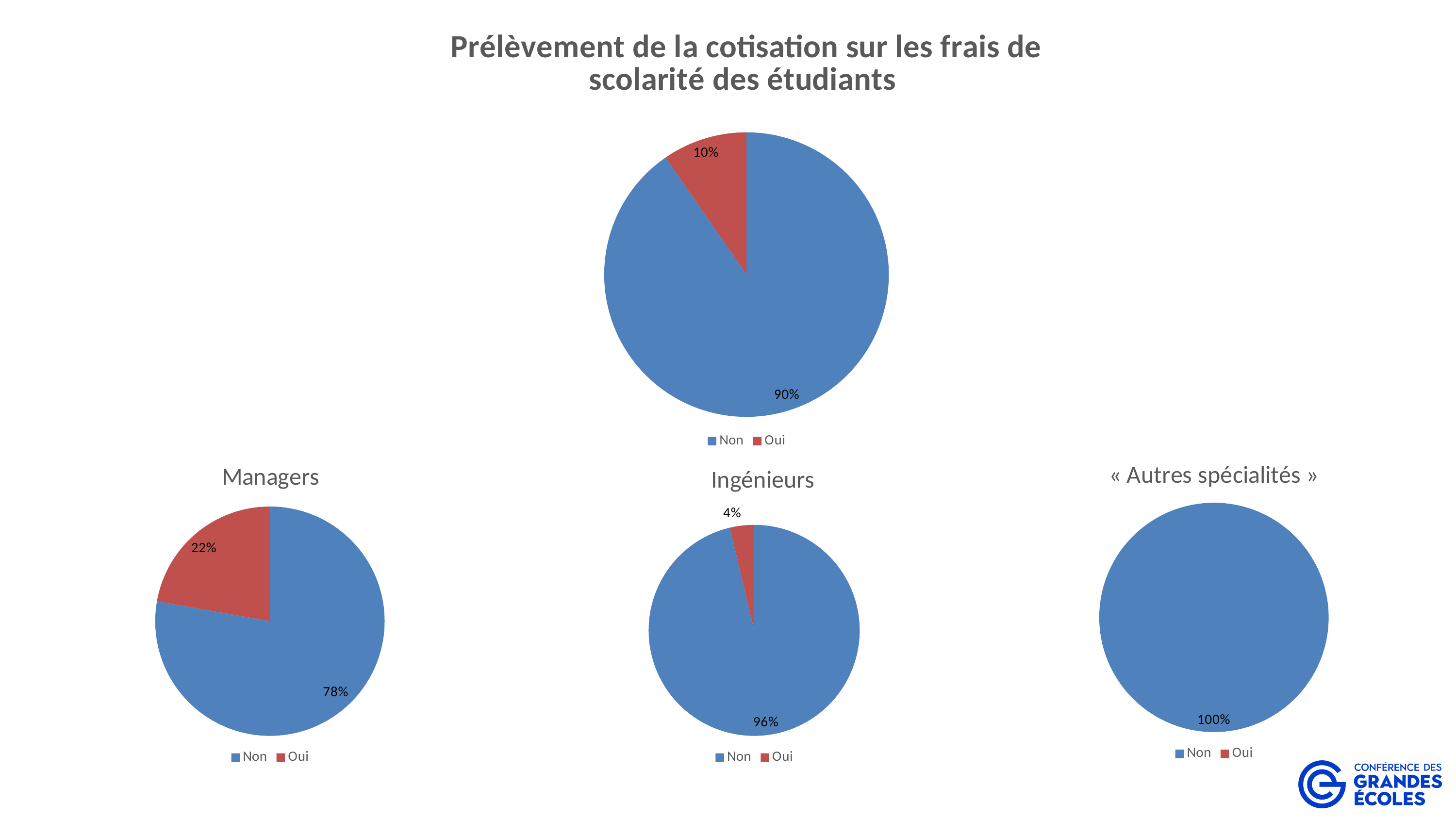
In the '« Autres spécialités »' chart, what share is labelled for 'Non'? 100% How many entries does the legend of the 'Managers' chart list? 2 What kind of chart is the 'Ingénieurs' chart? Pie chart In the 'Ingénieurs' chart, which slice is the smallest? Oui In the 'Ingénieurs' chart, what share is labelled for 'Non'? 96% In the 'Managers' chart, which slice is the largest? Non In the top chart titled 'Prélèvement de la cotisation sur les frais de scolarité des étudiants', what share is labelled for 'Oui'? 10% In the 'Managers' chart, what is the difference between the 'Non' share and the 'Oui' share? 56% In the 'Managers' chart, what share is labelled for 'Oui'? 22% In the 'Managers' chart, what share is labelled for 'Non'? 78% In the 'Ingénieurs' chart, what share is labelled for 'Oui'? 4% In the top chart titled 'Prélèvement de la cotisation sur les frais de scolarité des étudiants', what share is labelled for 'Non'? 90%